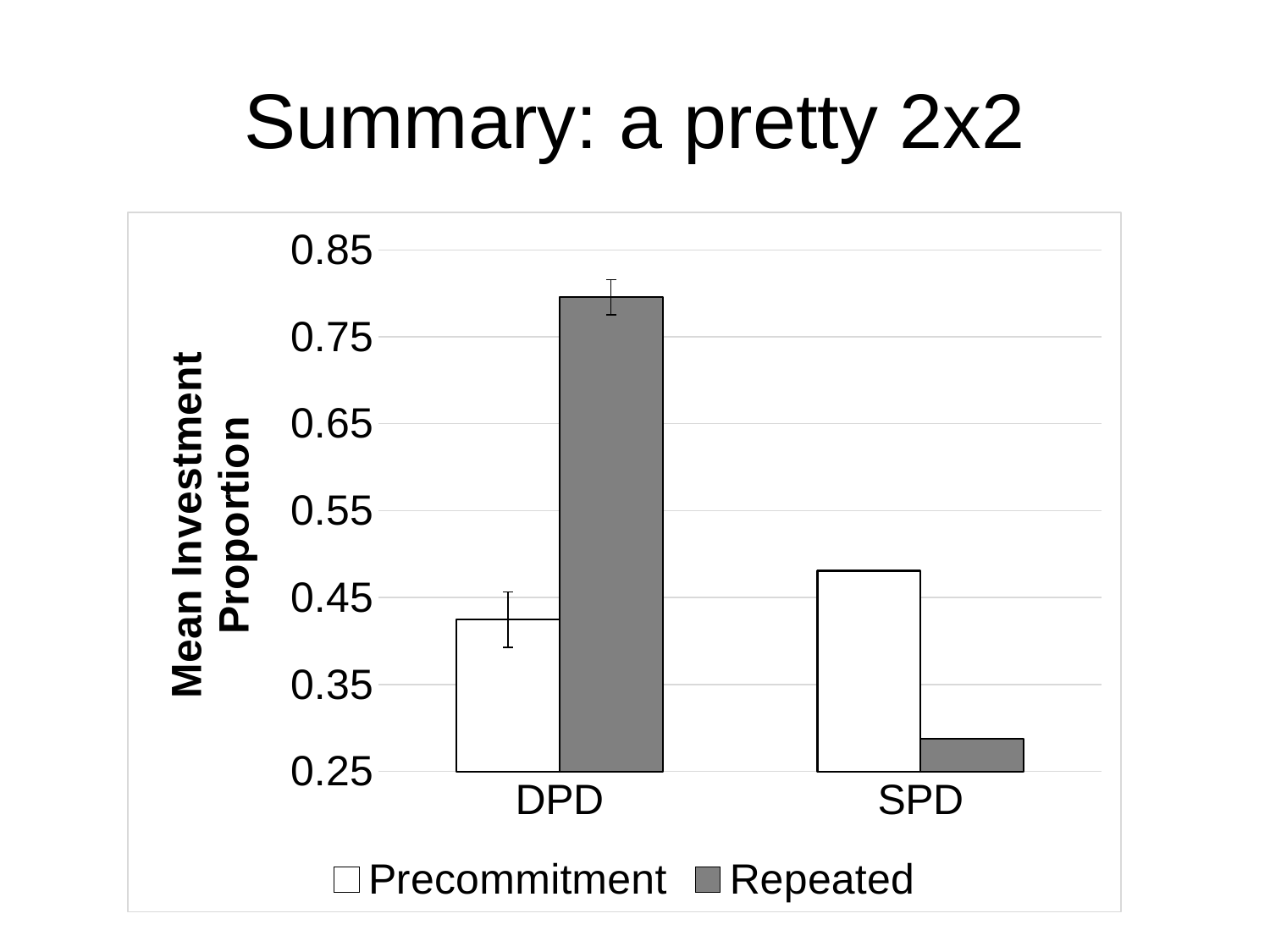
How many categories are shown on the x axis? 2 Is the Precommitment value for DPD greater or less than 0.55? less For SPD, which is larger: Precommitment or Repeated? Precommitment Which bar is the tallest in the chart? Repeated for DPD How many series does the legend list? 2 What is the title of the y axis? Mean Investment Proportion What kind of chart is shown on the slide? bar chart Is the Repeated value for DPD greater or less than 0.75? greater Is the Precommitment value for SPD greater or less than 0.45? greater Which bar is the shortest in the chart? Repeated for SPD For DPD, which is larger: Precommitment or Repeated? Repeated